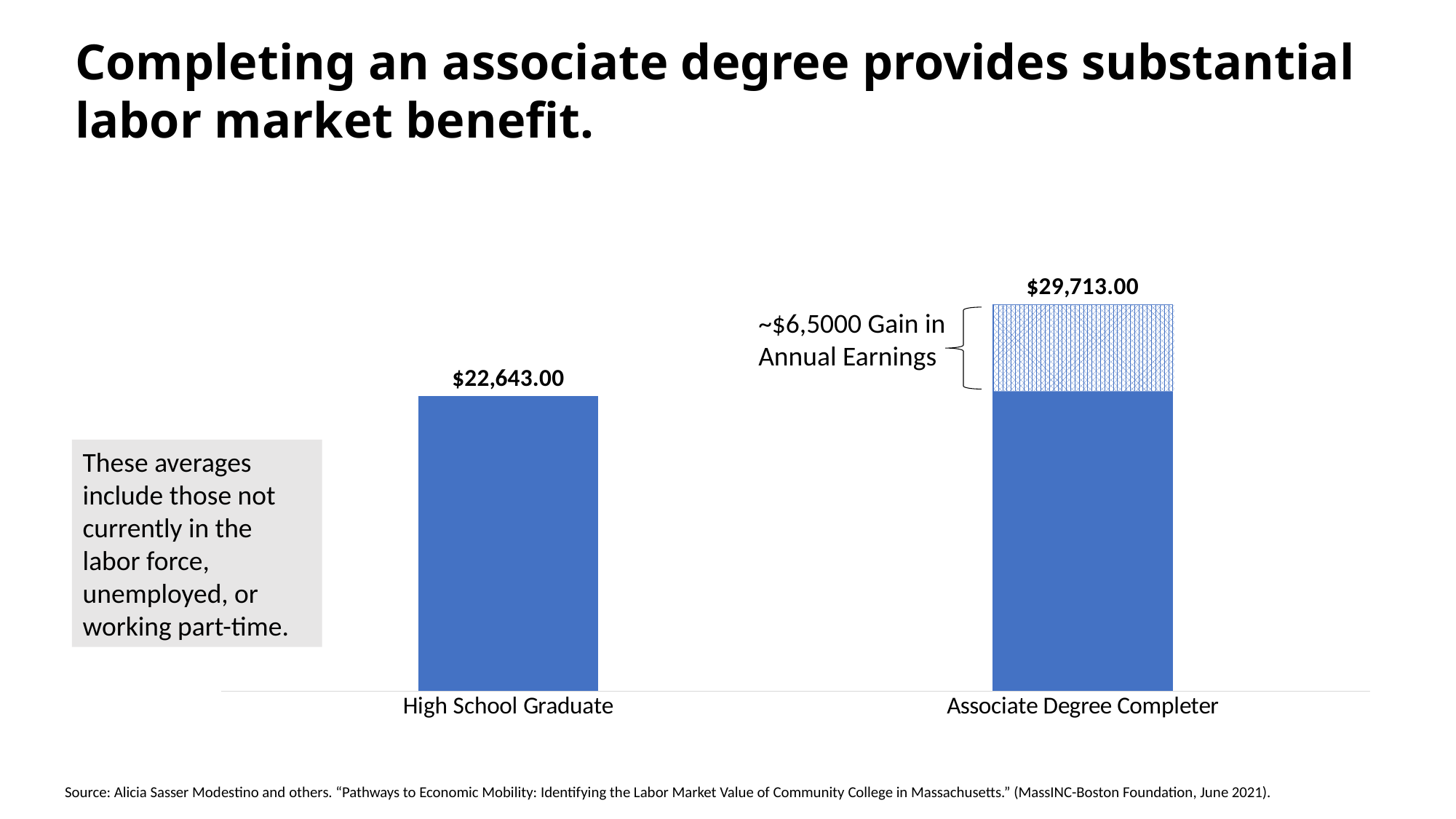
Which category has the higher value? Associate Degree Completer What does the annotation next to the bracket on the Associate Degree Completer bar say? ~$6,5000 Gain in Annual Earnings What is the value shown for High School Graduate? $22,643.00 Do the values rise or fall from High School Graduate to Associate Degree Completer? rise Which category has the lower value? High School Graduate What is the title of the slide containing the chart? Completing an associate degree provides substantial labor market benefit. What kind of chart is shown on the slide? bar chart How many categories are shown on the chart? 2 What is the difference between the Associate Degree Completer value and the High School Graduate value? $7,070.00 What is the value shown for Associate Degree Completer? $29,713.00 Is the value for Associate Degree Completer larger or smaller than the value for High School Graduate? larger